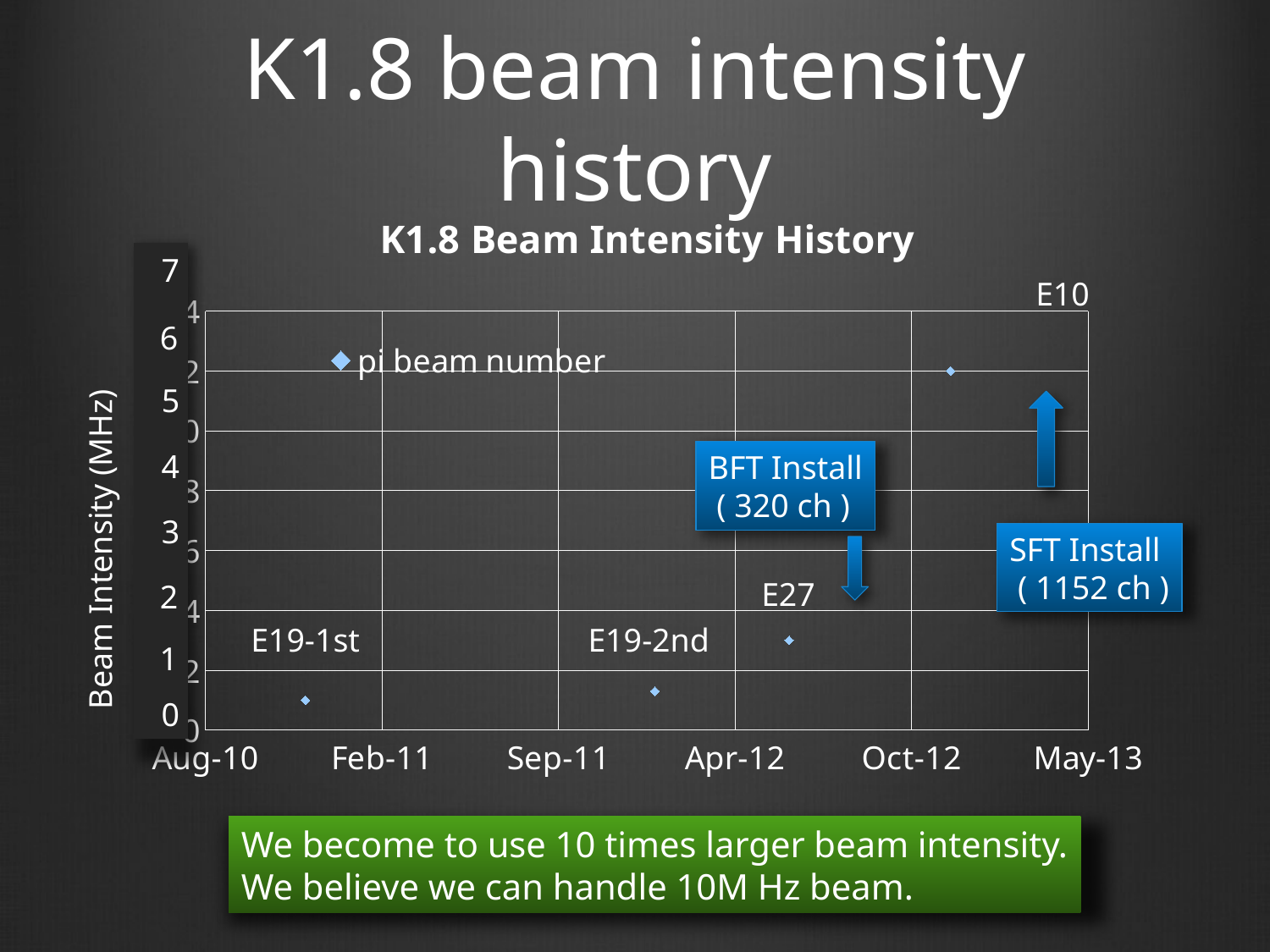
Which has a larger beam intensity, E10 or E27? E10 Is the beam intensity for E27 greater or less than 2 MHz? less What is the name of the series shown in the legend? pi beam number How many data points are plotted on the chart? 4 Is the beam intensity for E10 greater or less than 4 MHz? greater What is the title of the chart? K1.8 Beam Intensity History Which has a larger beam intensity, E27 or E19-2nd? E27 What type of chart is shown on the slide? scatter chart How many series does the chart legend list? 1 Does the beam intensity rise or fall over time along the x axis? rise Is the beam intensity for E19-1st greater or less than 1 MHz? less Which labelled data point has the highest beam intensity? E10